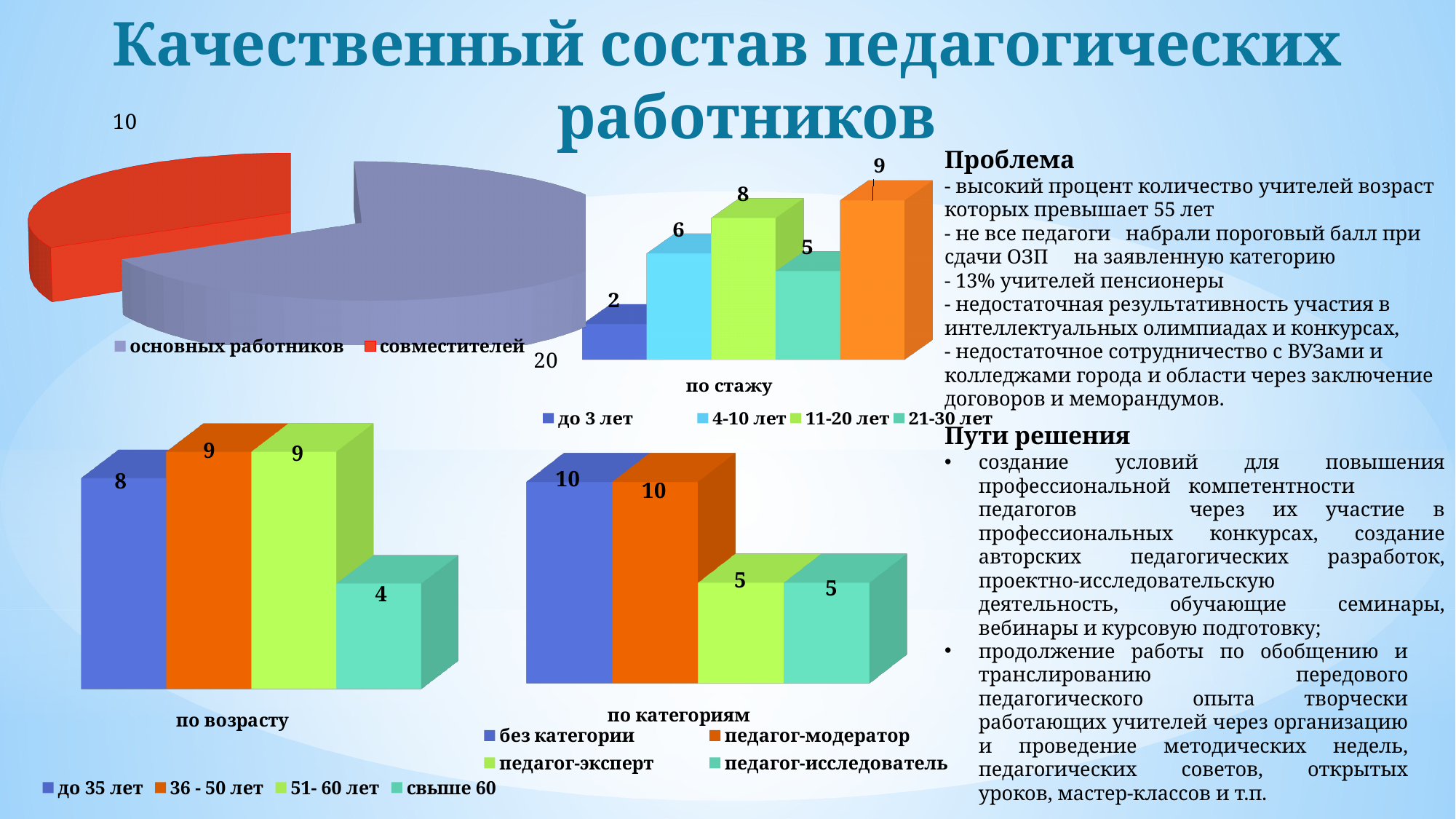
What kind of chart is the chart titled 'по категориям'? bar chart In the chart titled 'по возрасту', what is the value for до 35 лет? 8 In the pie chart at the top left, what is the value for основных работников? 20 In the chart titled 'по категориям', what is the value for педагог-модератор? 10 In the chart titled 'по стажу', what is the value for до 3 лет? 2 In the chart titled 'по категориям', which is larger: без категории or педагог-эксперт? без категории In the chart titled 'по возрасту', what is the difference between the values for 36 - 50 лет and свыше 60? 5 In the chart titled 'по возрасту', which category has the lowest value? свыше 60 In the pie chart at the top left, how many slices does the legend list? 2 In the pie chart at the top left, what is the value for совместителей? 10 In the chart titled 'по стажу', what is the value for 11-20 лет? 8 In the chart titled 'по стажу', what is the difference between the values for 4-10 лет and 21-30 лет? 1